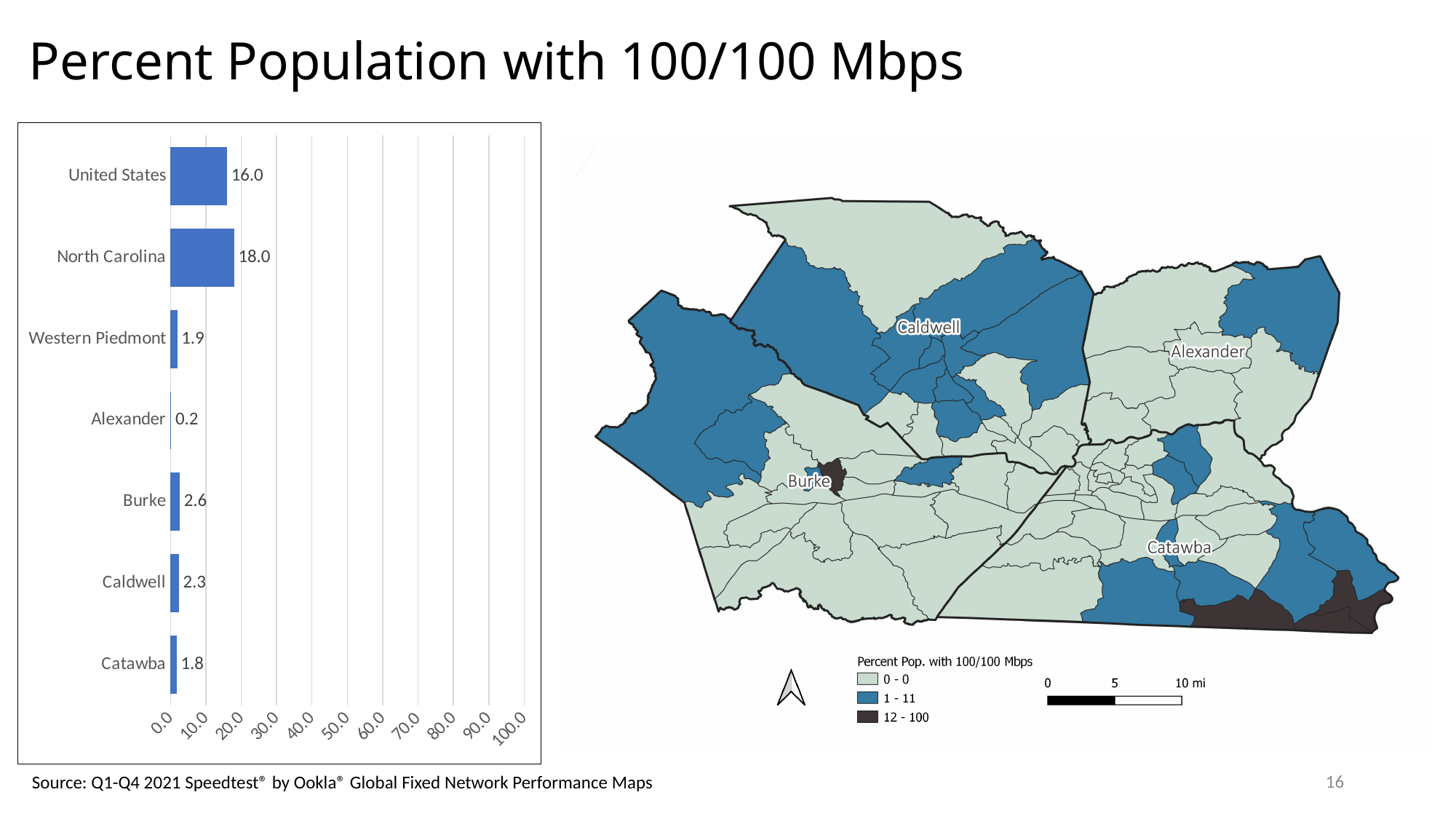
Which has a larger value in the bar chart, Caldwell or Catawba? Caldwell What is the value for North Carolina in the bar chart? 18.0 What is the maximum value shown on the x axis of the bar chart? 100.0 What kind of chart is on the left of the slide? Bar chart How many categories are shown in the bar chart? 7 Which category has the highest value in the bar chart? North Carolina What is the difference between the values for North Carolina and United States in the bar chart? 2.0 What is the value for Western Piedmont in the bar chart? 1.9 What is the value for Alexander in the bar chart? 0.2 What is the value for Burke in the bar chart? 2.6 Which category has the lowest value in the bar chart? Alexander What is the difference between the values for Burke and Catawba in the bar chart? 0.8